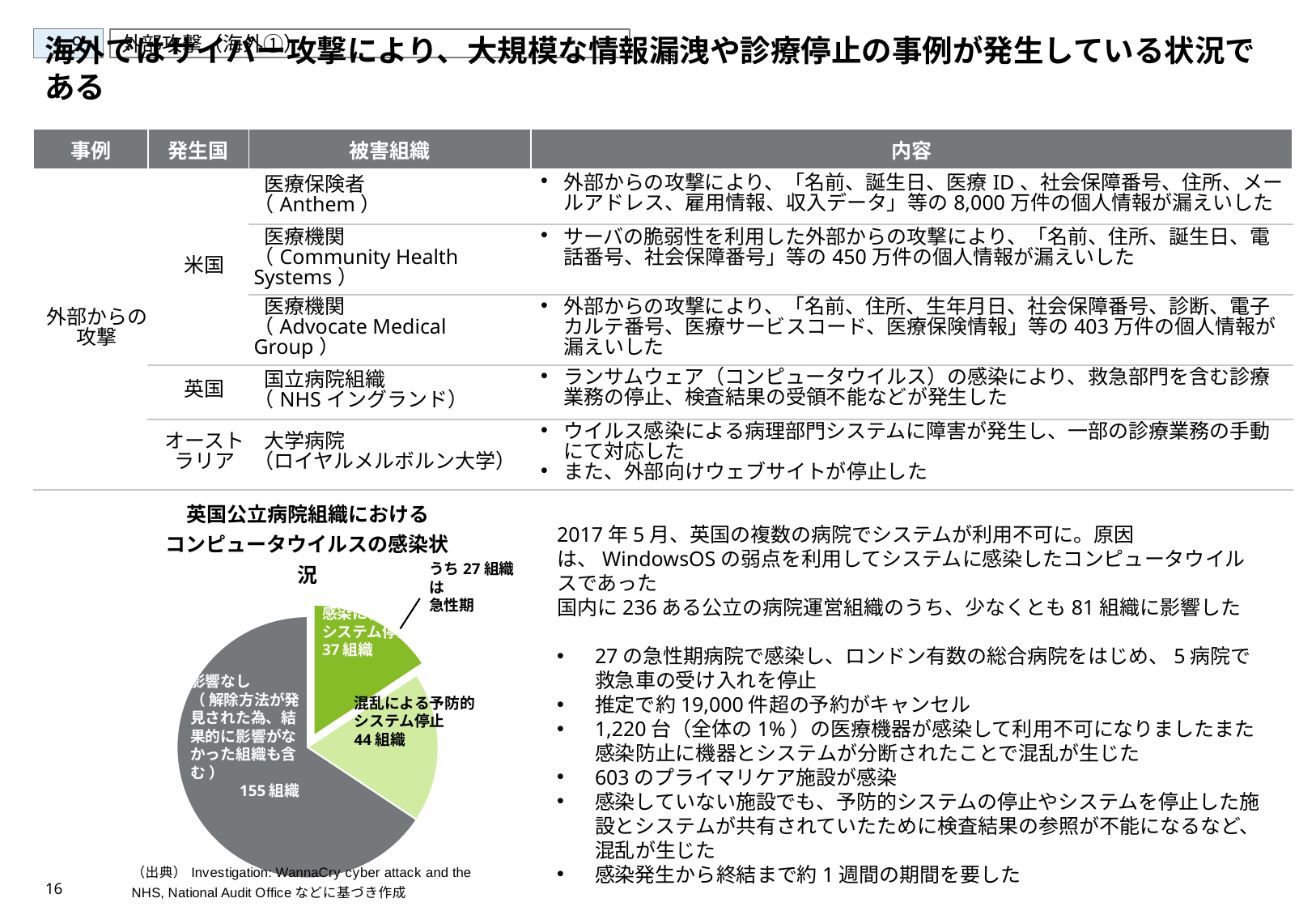
In the pie chart, how many organisations are in the 影響なし slice? 155組織 What is the total number of organisations across all slices of the pie chart? 236組織 How many slices does the pie chart have? 3 What is the title of the pie chart? 英国公立病院組織におけるコンピュータウイルスの感染状況 Which is larger in the pie chart: the 混乱による予防的システム停止 slice or the 37組織 slice? 混乱による予防的システム停止 Which slice of the pie chart is the largest? 影響なし What type of chart is shown at the bottom left of the slide? pie chart What is the value of the smallest slice in the pie chart? 37組織 According to the annotation on the pie chart, how many of the 37 organisations are acute-care (急性期)? 27組織 What share of the pie chart does the 影響なし slice represent? 65.7% In the pie chart, what is the difference between the 影響なし slice and the 混乱による予防的システム停止 slice? 111組織 In the pie chart, how many organisations are in the 混乱による予防的システム停止 slice? 44組織